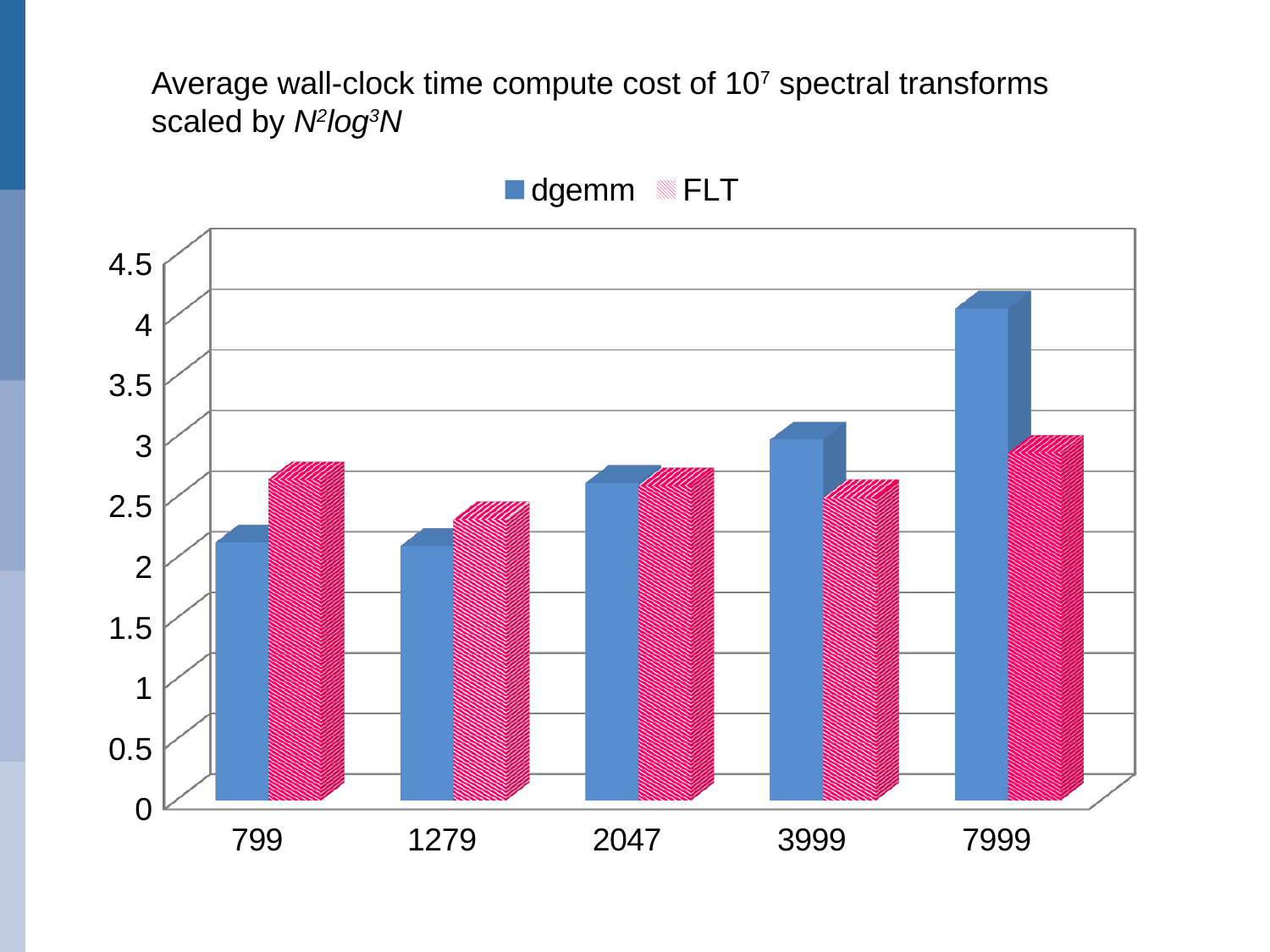
Which series is drawn with the pink hatched bars? FLT Is the dgemm value for 3999 greater or less than 2.5? greater Do the dgemm values generally rise or fall from 799 to 7999? rise How many series does the legend list? 2 For which category is the dgemm value highest? 7999 What kind of chart is shown on the slide? bar chart Is the FLT value for 7999 greater or less than 3.5? less At 7999, which series has the larger value, dgemm or FLT? dgemm Is the dgemm value for 799 greater or less than 2.5? less How many categories are shown on the x axis? 5 At 799, which series has the larger value, dgemm or FLT? FLT